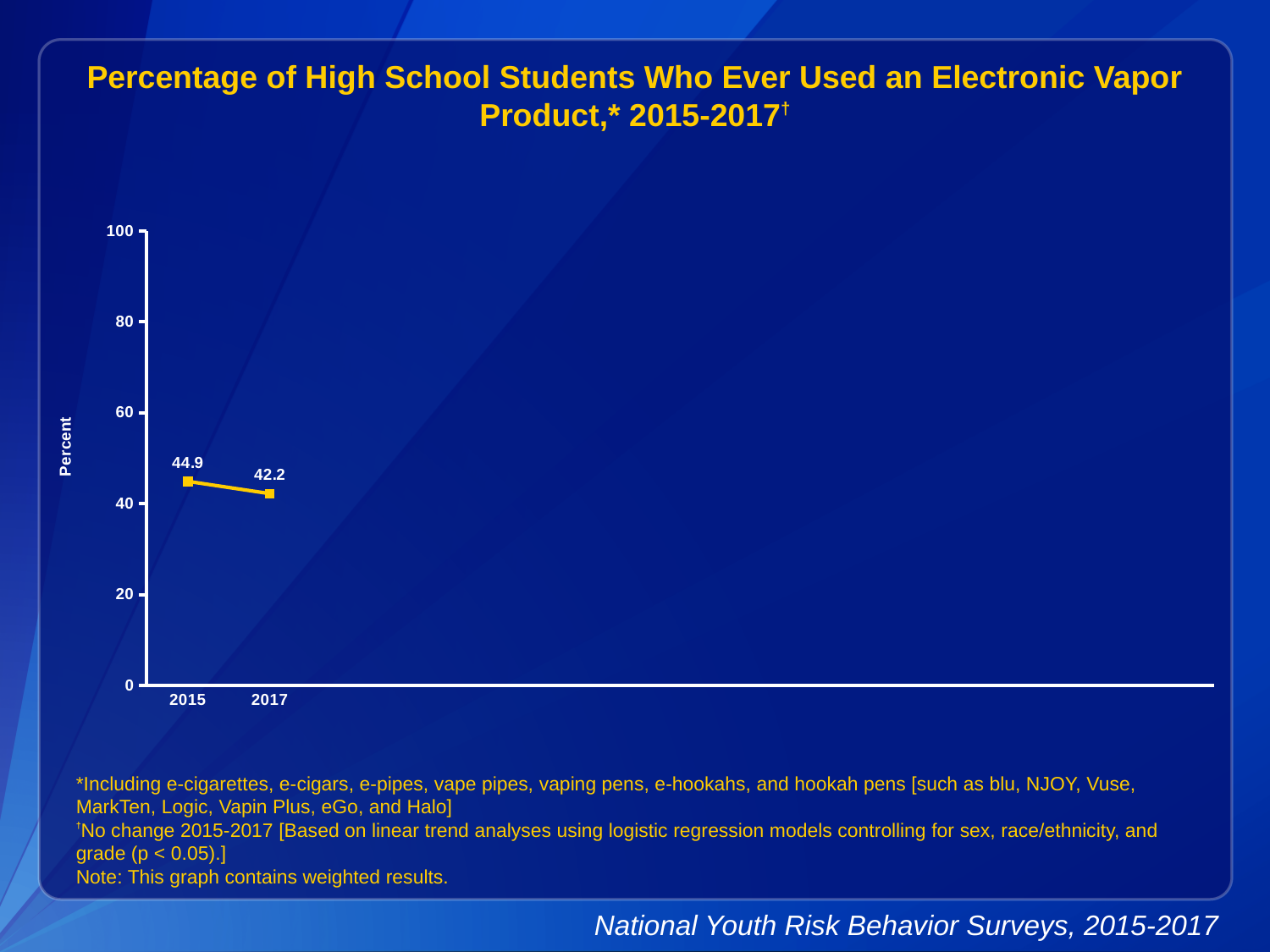
Is the value for 2015 greater or less than 40? greater Which year shows the lowest percentage on the chart? 2017 What is the percentage of high school students who ever used an electronic vapor product in 2015? 44.9 Which year has the higher percentage, 2015 or 2017? 2015 What is the label on the vertical axis of the chart? Percent What is the percentage of high school students who ever used an electronic vapor product in 2017? 42.2 Is the value for 2017 greater or less than 60? less How many data points are plotted on the chart? 2 Do the values rise or fall from 2015 to 2017? fall What is the maximum value shown on the vertical axis? 100 What is the difference between the 2015 and 2017 percentages? 2.7 What kind of chart is shown on the slide? line chart